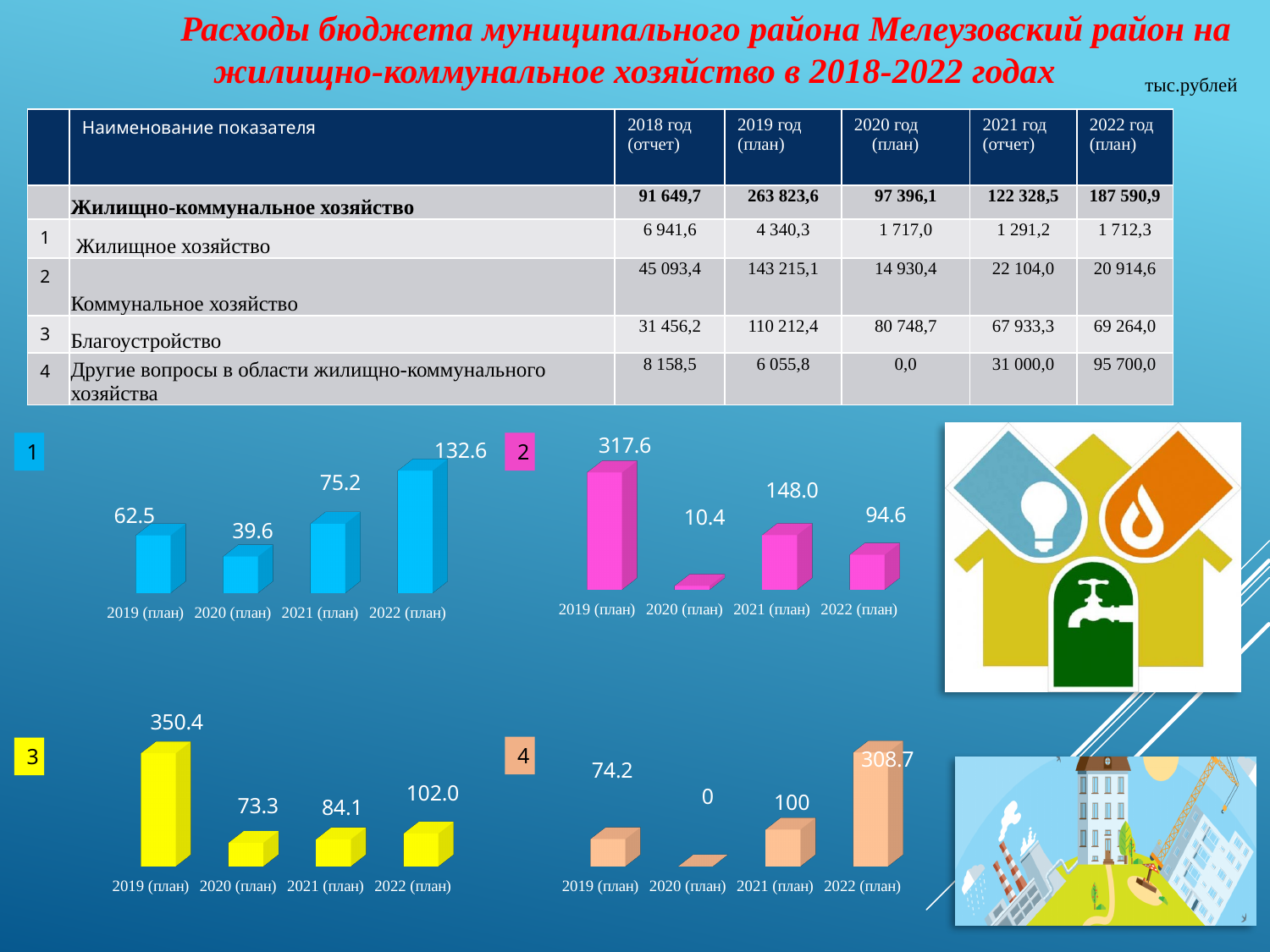
In chart 2 (the pink bar chart), which is larger, the value for 2021 (план) or 2022 (план)? 2021 (план) In chart 1 (the blue bar chart), what is the difference between the values for 2022 (план) and 2021 (план)? 57.4 In chart 1 (the blue bar chart at the top left), what is the value for 2022 (план)? 132.6 How many categories are shown in chart 3 (the yellow bar chart)? 4 In chart 3 (the yellow bar chart), what is the value for 2020 (план)? 73.3 In chart 2 (the pink bar chart), what is the value for 2019 (план)? 317.6 What kind of chart is chart 2 (the pink chart)? bar chart In chart 3 (the yellow bar chart), what is the difference between the values for 2019 (план) and 2022 (план)? 248.4 In chart 4 (the orange bar chart at the bottom), do the values rise or fall from 2020 (план) to 2022 (план)? rise In chart 2 (the pink bar chart), which category has the highest value? 2019 (план) In chart 1 (the blue bar chart), which category has the lowest value? 2020 (план) In chart 4 (the orange bar chart at the bottom), what is the value for 2020 (план)? 0